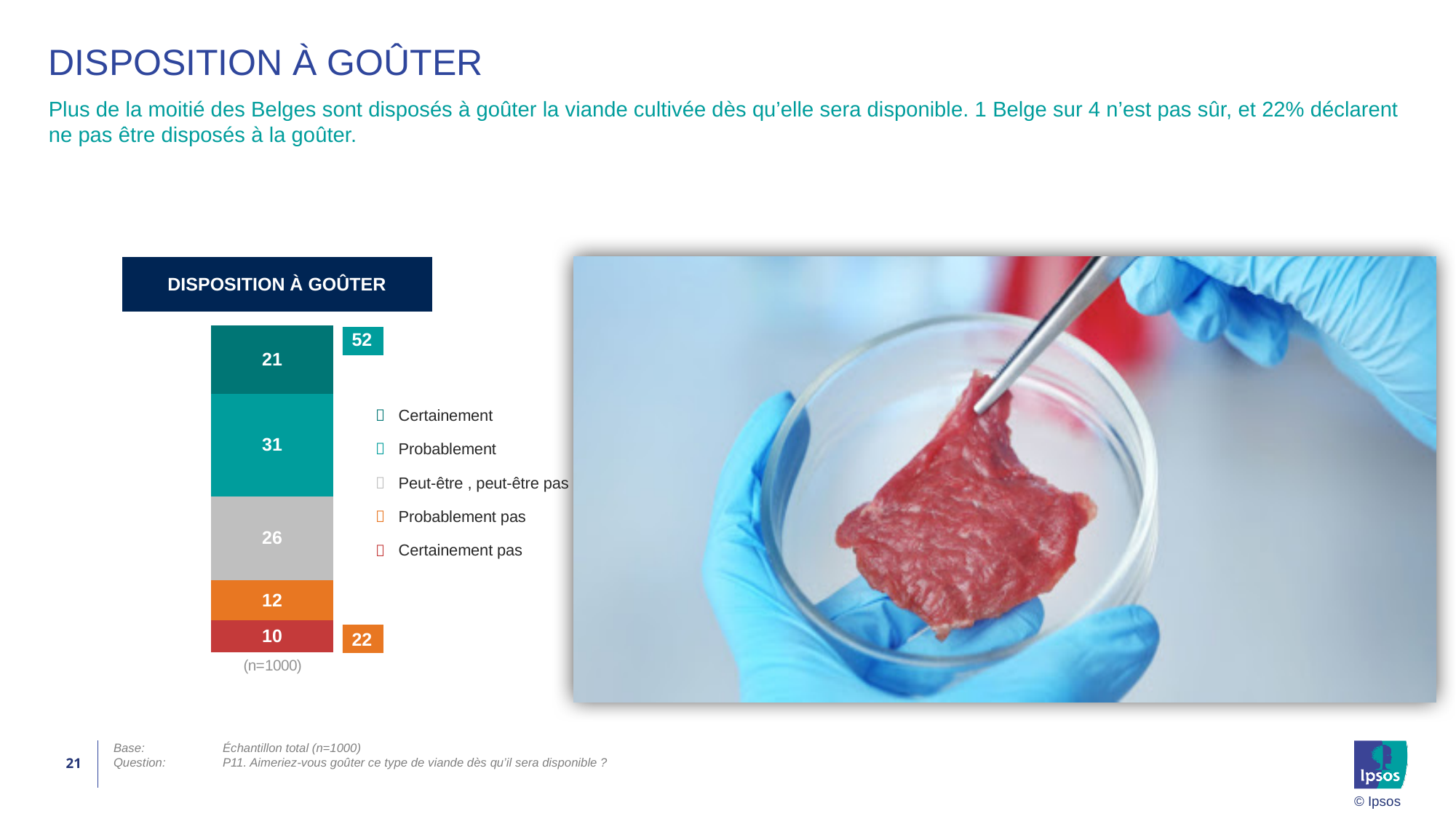
What is the combined value shown for "Probablement pas" and "Certainement pas" (the label next to the bottom of the bar)? 22 What value is shown for the "Probablement" segment? 31 What value is shown for the "Peut-être, peut-être pas" segment? 26 What value is shown for the "Certainement" segment of the stacked bar? 21 Which response category has the largest value in the stacked bar? Probablement What type of chart is shown on the slide? Stacked bar chart Which response category has the smallest value in the stacked bar? Certainement pas What is the combined value shown for "Certainement" and "Probablement" (the label next to the top of the bar)? 52 Which is larger, the value for "Probablement pas" or the value for "Certainement pas"? Probablement pas What is the difference between the "Probablement" and "Certainement" values? 10 How many response categories does the legend list? 5 What value is shown for the "Certainement pas" segment? 10